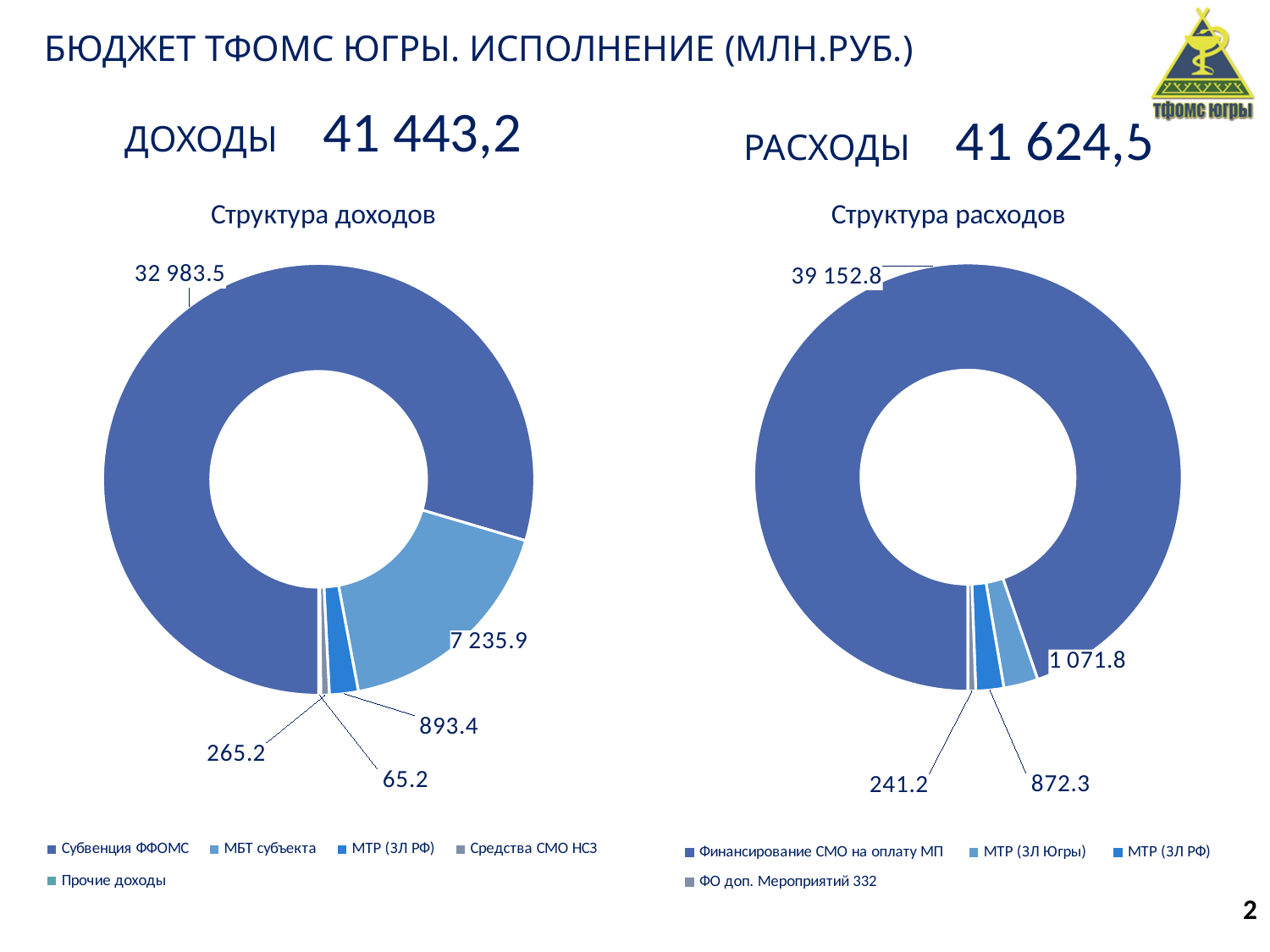
In the 'Структура доходов' chart, what is the value for Субвенция ФФОМС? 32 983.5 What type of chart is the 'Структура расходов' chart? Doughnut (pie) chart How many categories does the legend of the 'Структура расходов' chart list? 4 In the 'Структура доходов' chart, which category has the smallest value? Прочие доходы In the 'Структура расходов' chart, what is the value for Финансирование СМО на оплату МП? 39 152.8 In the 'Структура расходов' chart, what is the value for МТР (ЗЛ Югры)? 1 071.8 In the 'Структура доходов' chart, which category has the largest value? Субвенция ФФОМС In the 'Структура доходов' chart, what is the value for МБТ субъекта? 7 235.9 In the 'Структура расходов' chart, what is the difference between МТР (ЗЛ Югры) and МТР (ЗЛ РФ)? 199.5 How many categories does the legend of the 'Структура доходов' chart list? 5 In the 'Структура доходов' chart, which is larger: МТР (ЗЛ РФ) or Средства СМО НСЗ? МТР (ЗЛ РФ) In the 'Структура расходов' chart, which category has the smallest value? ФО доп. Мероприятий 332